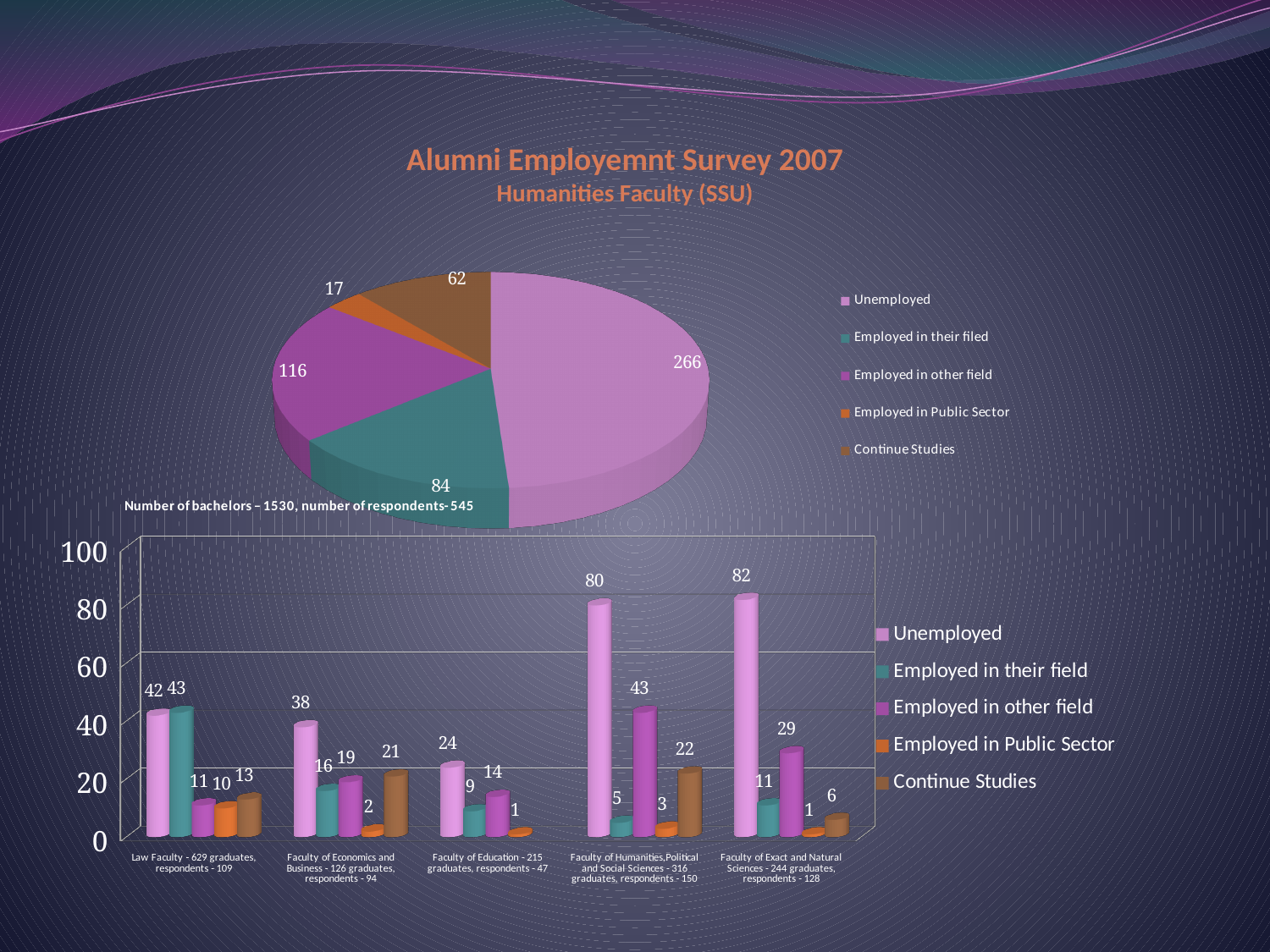
In the pie chart, what is the difference between Employed in other field and Employed in their field? 32 In the bar chart, which faculty has the highest Unemployed value? Faculty of Exact and Natural Sciences In the pie chart, which category has the smallest slice? Employed in Public Sector In the bar chart, what is the difference between the Unemployed values for the Faculty of Humanities, Political and Social Sciences and the Law Faculty? 38 In the bar chart, what is the Employed in other field value for the Faculty of Humanities, Political and Social Sciences? 43 In the bar chart, which faculty has the highest Employed in their field value? Law Faculty In the pie chart, what is the value for Employed in Public Sector? 17 In the bar chart, what is the Unemployed value for the Faculty of Exact and Natural Sciences? 82 How many series does the legend of the bar chart list? 5 In the pie chart, how many slices are there? 5 In the bar chart, is the Continue Studies value larger for the Faculty of Economics and Business or for the Faculty of Exact and Natural Sciences? Faculty of Economics and Business In the pie chart, what is the value for Unemployed? 266